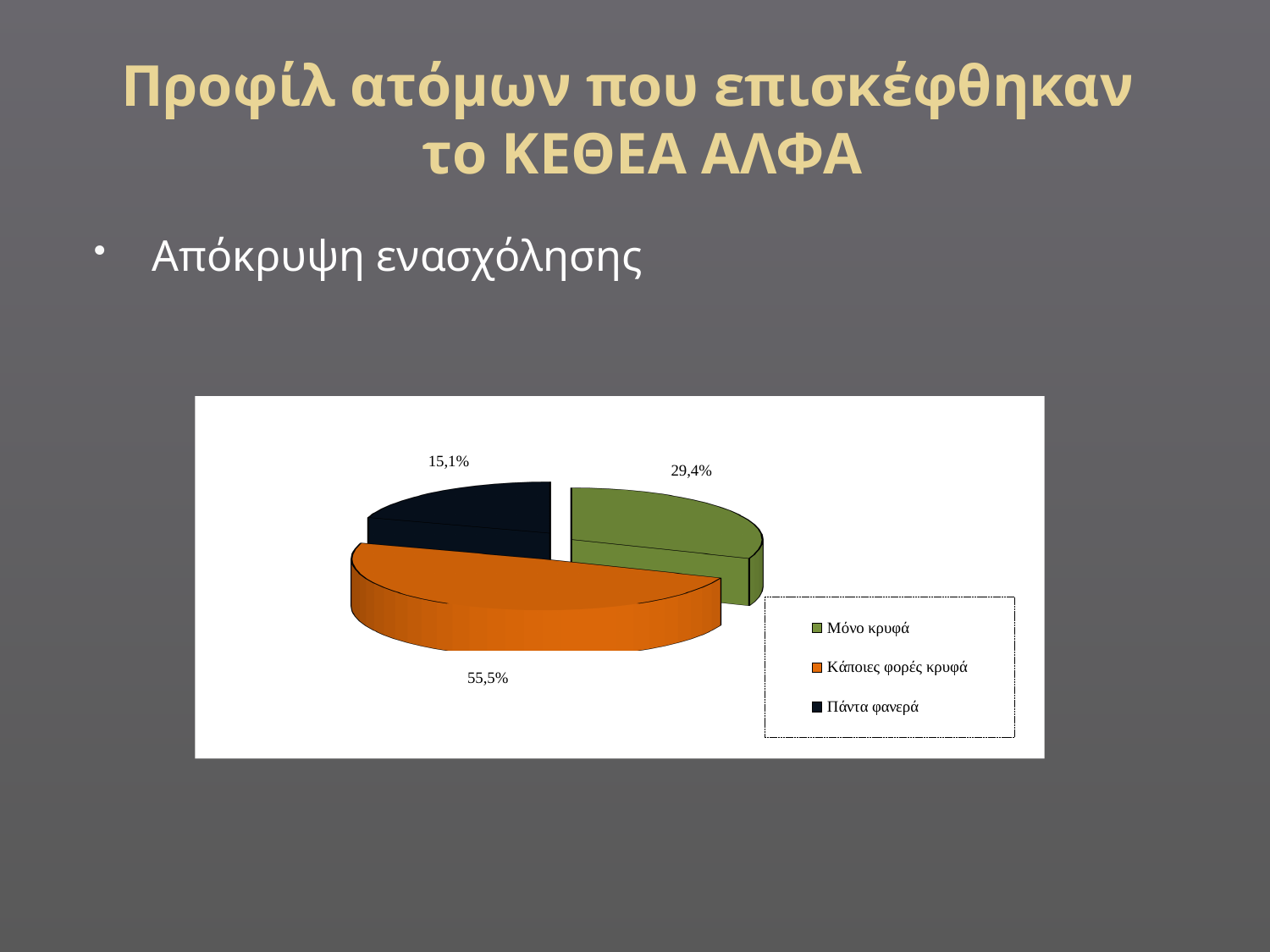
What colour is the slice for "Κάποιες φορές κρυφά"? Orange What percentage is shown for "Κάποιες φορές κρυφά"? 55,5% Which category has the largest share of the pie? Κάποιες φορές κρυφά What kind of chart is shown on the slide? Pie chart What is the difference in percentage points between "Κάποιες φορές κρυφά" and "Μόνο κρυφά"? 26,1 Which category has the smallest share of the pie? Πάντα φανερά What percentage is shown for "Πάντα φανερά"? 15,1% Which is larger, the share for "Μόνο κρυφά" or the share for "Πάντα φανερά"? Μόνο κρυφά What is the difference in percentage points between "Μόνο κρυφά" and "Πάντα φανερά"? 14,3 How many entries does the legend list? 3 How many slices does the pie chart have? 3 What percentage is shown for "Μόνο κρυφά"? 29,4%